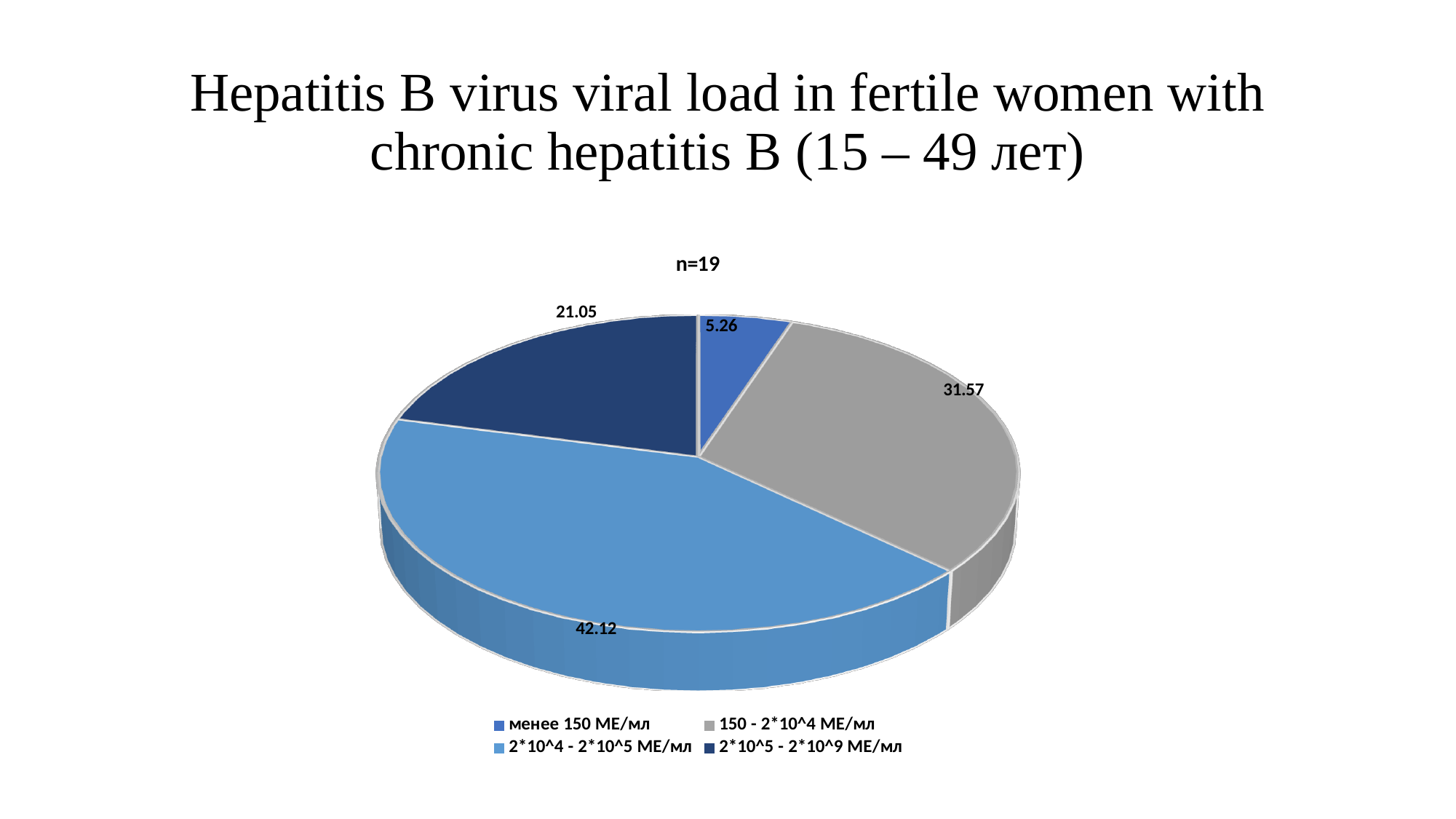
What is the title printed above the pie chart? n=19 What colour is the slice for '150 - 2*10^4 МЕ/мл'? gray What is the difference between the values for '2*10^4 - 2*10^5 МЕ/мл' and '150 - 2*10^4 МЕ/мл'? 10.55 What is the value shown for the slice labelled '150 - 2*10^4 МЕ/мл'? 31.57 What is the value shown for the slice labelled '2*10^4 - 2*10^5 МЕ/мл'? 42.12 What is the value shown for the slice labelled 'менее 150 МЕ/мл'? 5.26 What is the value shown for the slice labelled '2*10^5 - 2*10^9 МЕ/мл'? 21.05 What type of chart is shown on the slide? pie chart Which is larger: the value for '2*10^5 - 2*10^9 МЕ/мл' or the value for '150 - 2*10^4 МЕ/мл'? 150 - 2*10^4 МЕ/мл Which category has the smallest slice of the pie? менее 150 МЕ/мл Which category has the largest slice of the pie? 2*10^4 - 2*10^5 МЕ/мл How many slices does the pie chart have? 4